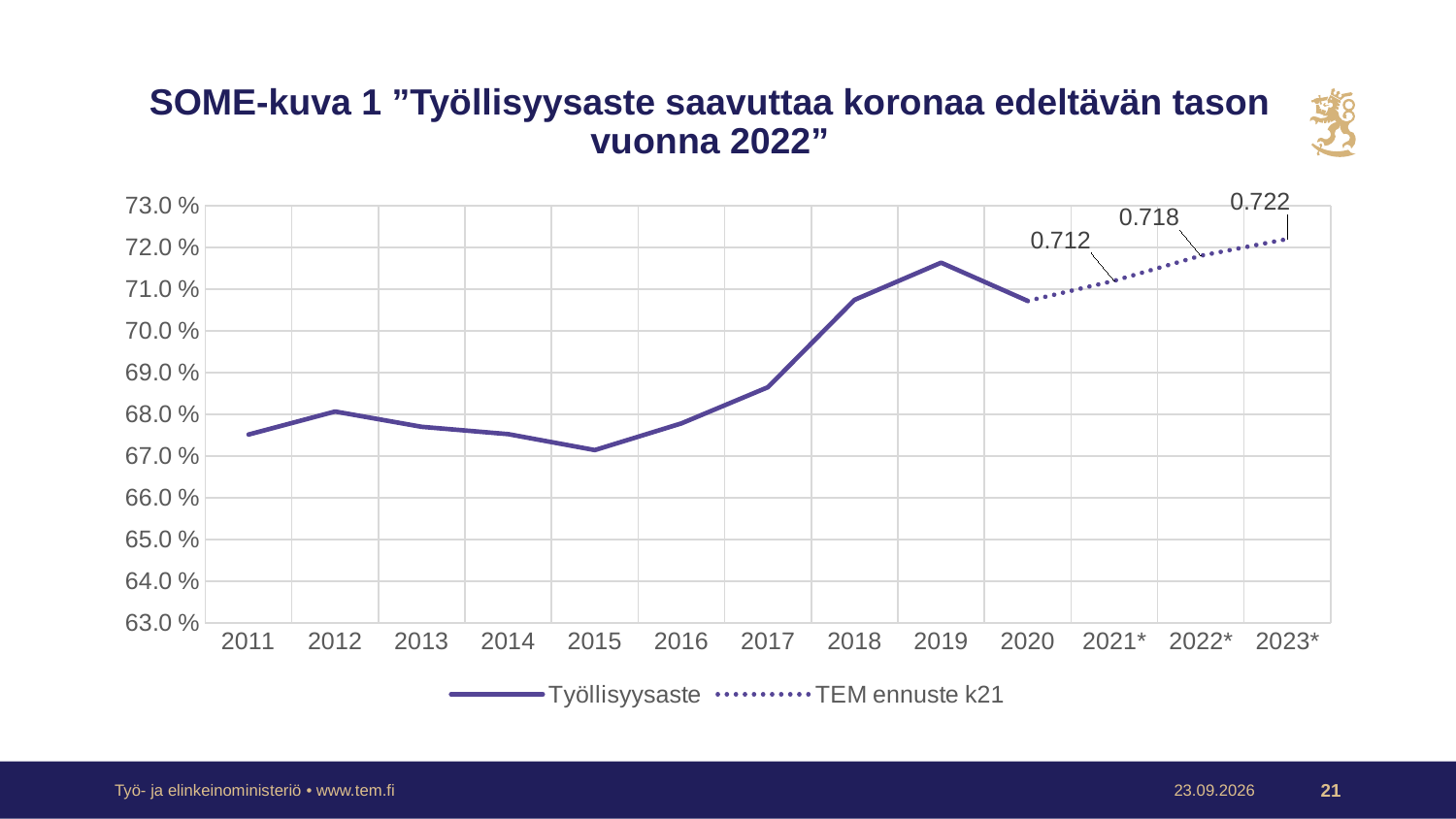
What is the difference between the TEM ennuste k21 values for 2023* and 2021*? 0.010 What is the TEM ennuste k21 value for 2022*? 0.718 What is the TEM ennuste k21 value for 2021*? 0.712 Is the Työllisyysaste value for 2019 greater or less than 71.0 %? greater In which year does the Työllisyysaste series reach its lowest value? 2015 What kind of chart is shown on the slide? line chart Does the Työllisyysaste series rise or fall between 2015 and 2019? rise What is the TEM ennuste k21 value for 2023*? 0.722 How many years are shown on the x axis? 13 In which year does the Työllisyysaste series reach its highest value? 2019 How many series does the legend list? 2 What are the two series named in the legend? Työllisyysaste and TEM ennuste k21